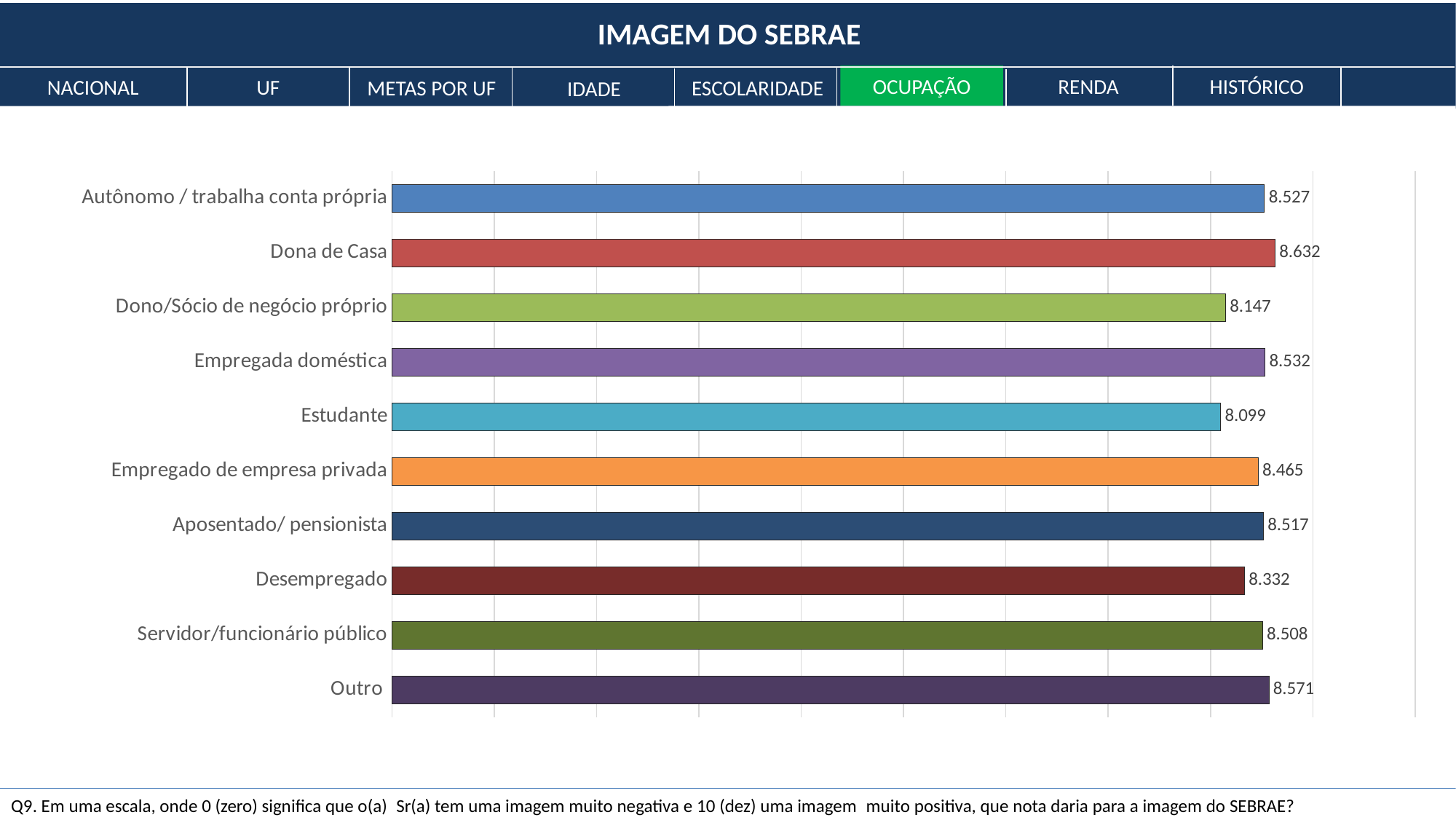
What is the value for Desempregado? 8.332 Which is larger, the value for Outro or the value for Empregado de empresa privada? Outro Which category has the lowest value? Estudante What is the difference between the values for Desempregado and Dono/Sócio de negócio próprio? 0.185 What kind of chart is shown on the slide? Bar chart What is the value for Servidor/funcionário público? 8.508 What is the title shown at the top of the slide? IMAGEM DO SEBRAE What is the value for Estudante? 8.099 Which category has the highest value? Dona de Casa What is the difference between the values for Dona de Casa and Estudante? 0.533 What is the value for Dona de Casa? 8.632 How many categories are shown in the chart? 10